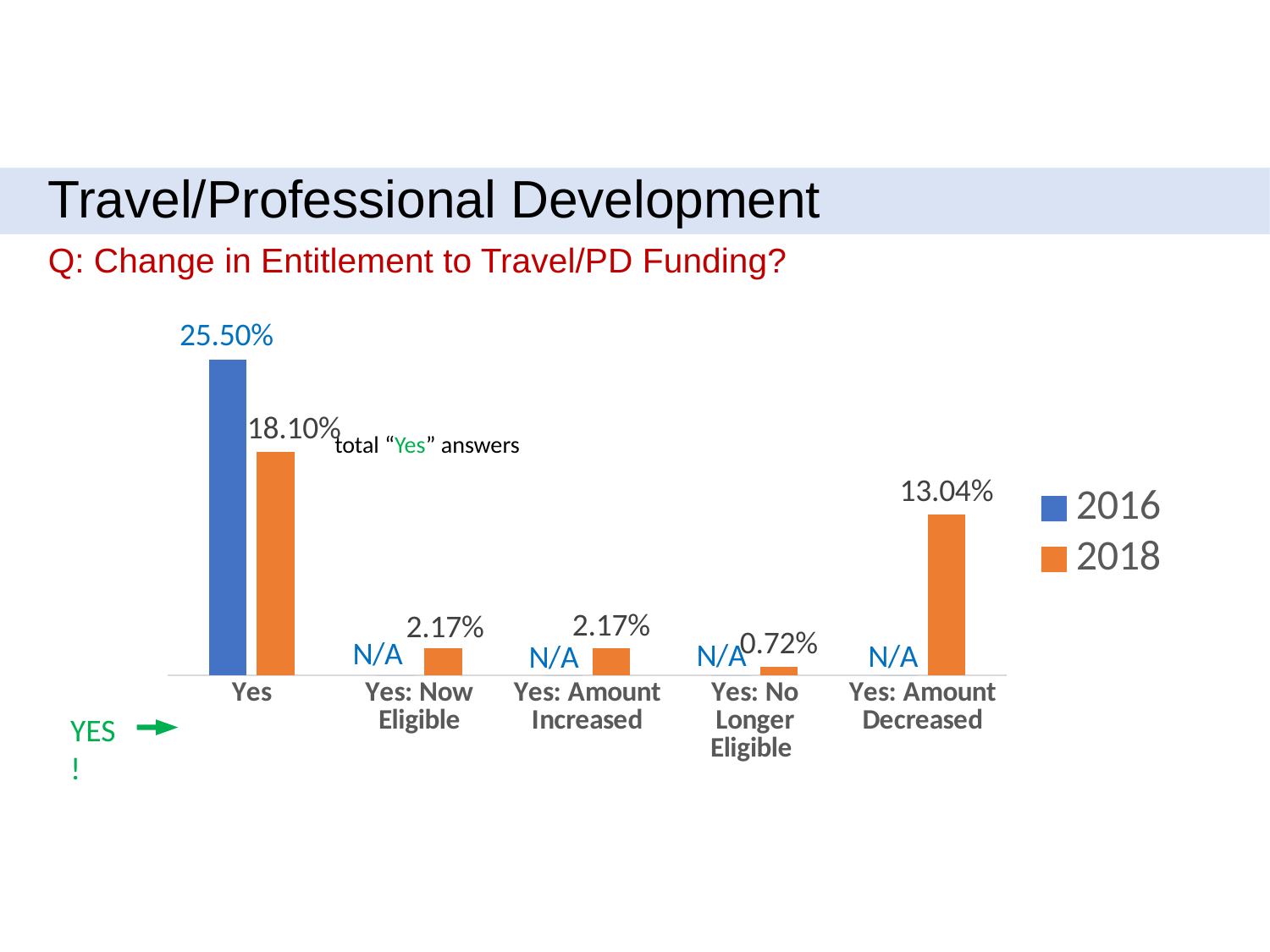
What is the 2018 value for "Yes"? 18.10% What kind of chart is shown on the slide? bar chart Which category has the highest 2018 value? Yes What is the 2016 value shown for "Yes: Now Eligible"? N/A How many series does the legend list? 2 How many categories are shown on the x axis? 5 Which category has the lowest 2018 value? Yes: No Longer Eligible What is the difference between the 2016 and 2018 values for "Yes"? 7.40% What is the 2016 value for "Yes"? 25.50% What is the 2018 value for "Yes: No Longer Eligible"? 0.72% Which series is shown in orange in the legend? 2018 What is the 2018 value for "Yes: Amount Decreased"? 13.04%